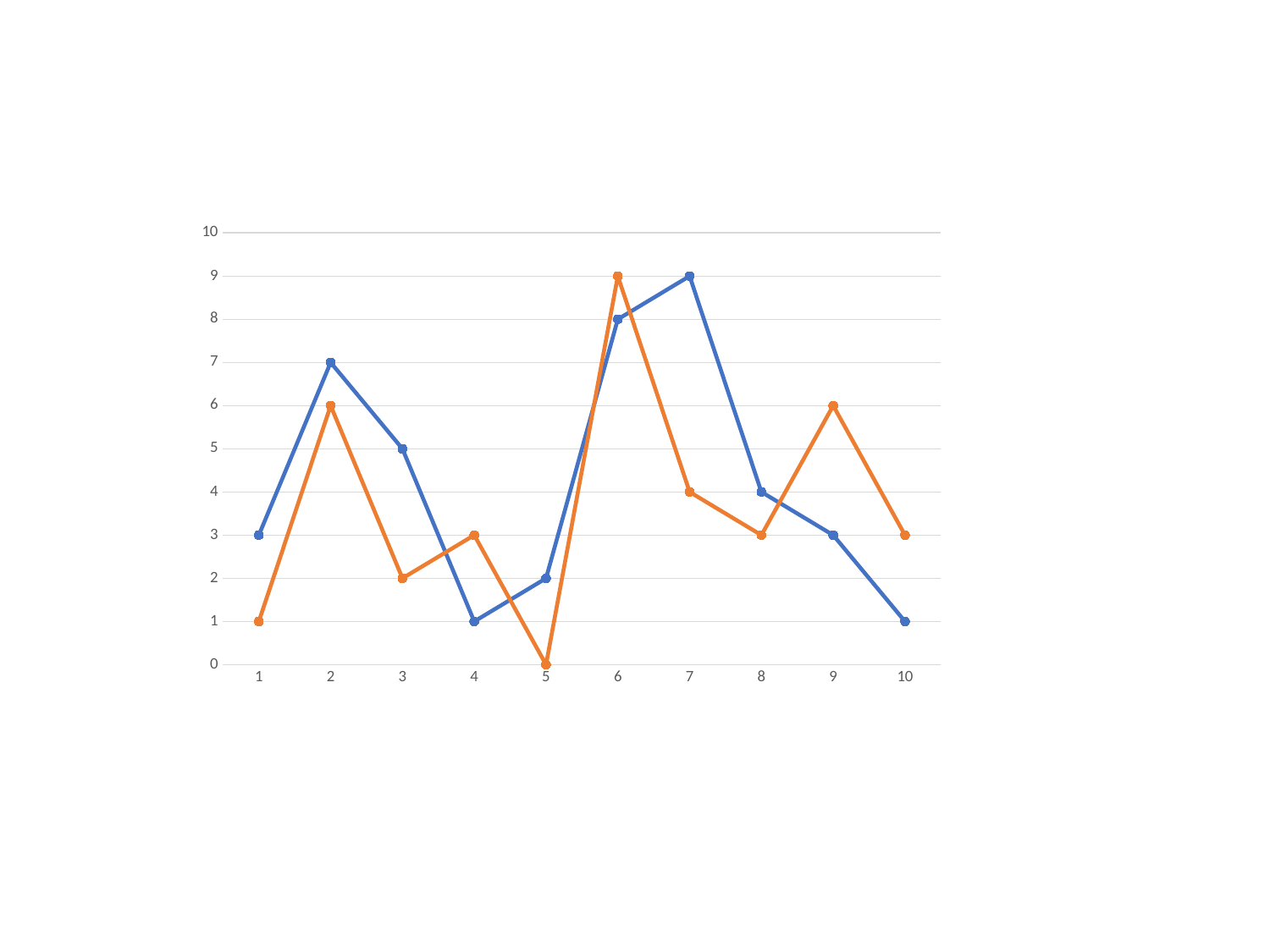
At x = 4, which line has the larger value, blue or orange? orange At which x value does the blue line reach its highest point? 7 What kind of chart is shown on the slide? line chart What is the value of the orange line at x = 9? 6 What is the difference between the blue line and the orange line at x = 7? 5 What is the value of the blue line at x = 7? 9 What is the value of the orange line at x = 5? 0 At which x value does the orange line reach its highest point? 6 What is the value of the blue line at x = 2? 7 How many points are plotted along the x axis for each line? 10 Does the blue line rise or fall from x = 7 to x = 10? fall At which x value does the orange line reach its lowest point? 5